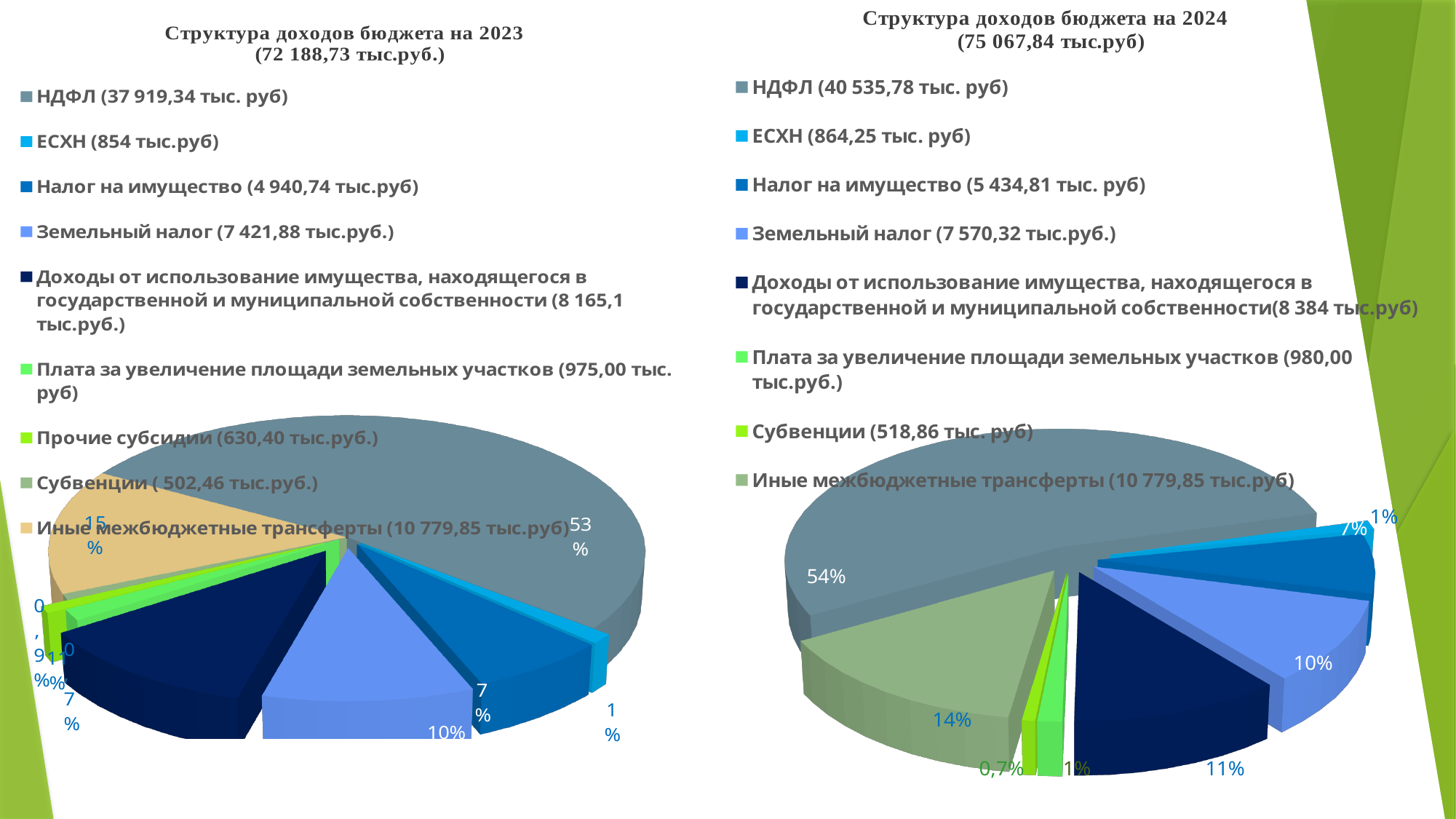
What total budget revenue is shown in the title of the 2024 chart? 75 067,84 тыс.руб In the 2024 chart, what share of the pie does Иные межбюджетные трансферты take? 14% In the 2023 chart (Структура доходов бюджета на 2023), how many categories does the legend list? 9 In the 2023 chart, what share of the pie does НДФЛ take? 53% In the 2024 chart, what share of the pie does Субвенции take? 0,7% In the 2023 chart, what value is given in the legend for Земельный налог? 7 421,88 тыс.руб. In the 2024 chart, what value is given in the legend for Налог на имущество? 5 434,81 тыс. руб In the 2024 chart, which category has the largest share? НДФЛ In the 2024 chart (Структура доходов бюджета на 2024), how many categories does the legend list? 8 In the 2024 chart, which is larger: the share for Земельный налог or the share for Налог на имущество? Земельный налог What kind of chart is used on the left side of the slide for the 2023 budget revenue structure? pie chart